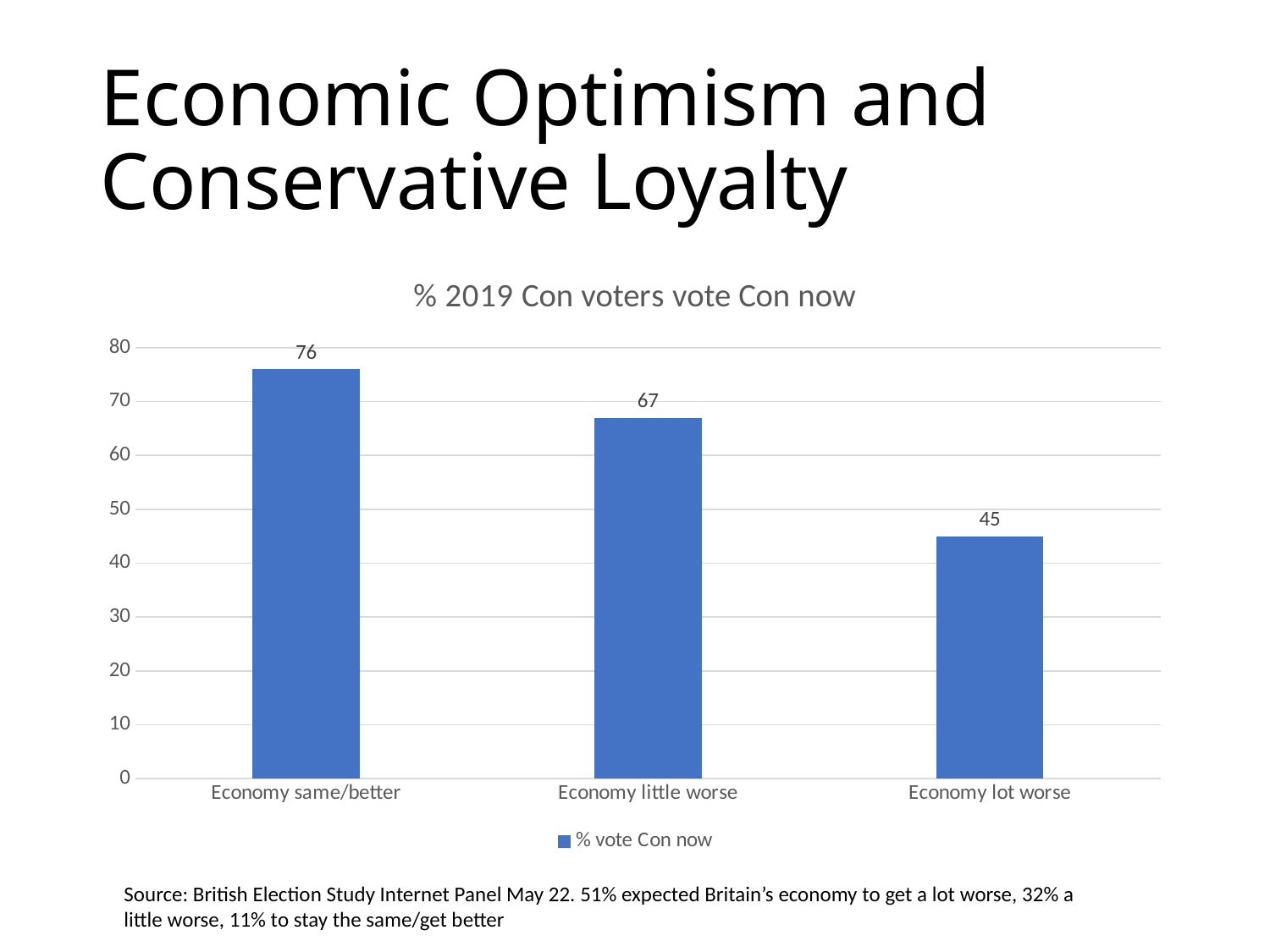
What kind of chart is shown on the slide? bar chart Which category has the lowest value? Economy lot worse What is the title of the chart? % 2019 Con voters vote Con now What is the difference between the values for Economy same/better and Economy little worse? 9 How many categories are shown on the x axis? 3 What is the value for Economy same/better? 76 What is the value for Economy lot worse? 45 What is the value for Economy little worse? 67 Is the value for Economy lot worse greater or less than 50? less What is the difference between the values for Economy same/better and Economy lot worse? 31 Which is larger, the value for Economy little worse or the value for Economy lot worse? Economy little worse Which category has the highest value? Economy same/better